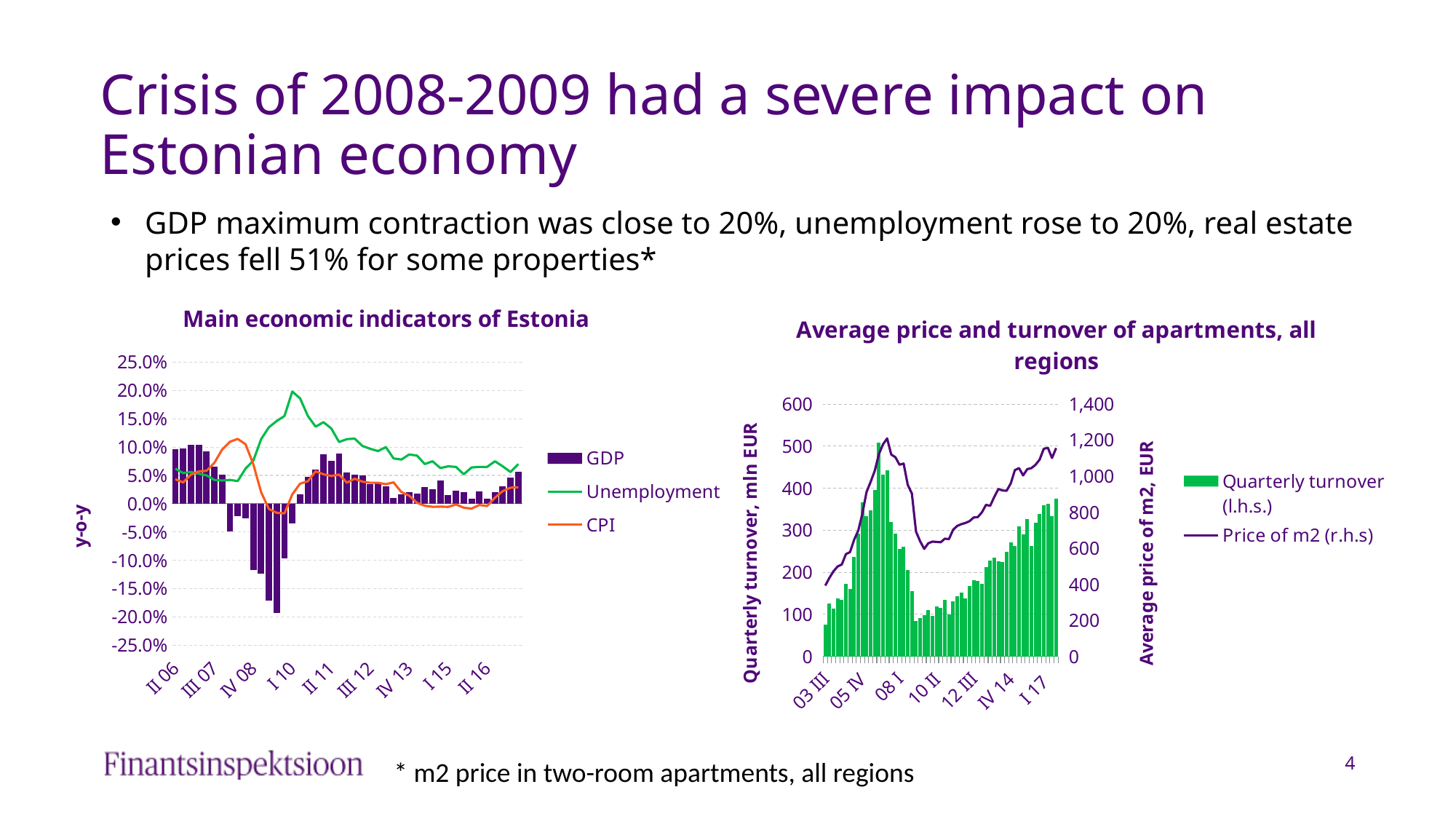
On the 'Main economic indicators of Estonia' chart, which series is drawn as bars? GDP On the 'Average price and turnover of apartments, all regions' chart, is the Quarterly turnover at 03 III greater or less than 100? less On the 'Main economic indicators of Estonia' chart, does Unemployment rise or fall between I 10 and II 16? fall On the 'Main economic indicators of Estonia' chart, how many series does the legend list? 3 On the 'Average price and turnover of apartments, all regions' chart, is the peak Price of m2 greater or less than 1,000? greater On the 'Main economic indicators of Estonia' chart, is the lowest GDP value greater or less than -15.0%? less On the 'Average price and turnover of apartments, all regions' chart, what is the label of the right-hand vertical axis? Average price of m2, EUR On the 'Average price and turnover of apartments, all regions' chart, how many series does the legend list? 2 On the 'Main economic indicators of Estonia' chart, what is the label of the vertical axis? y-o-y On the 'Average price and turnover of apartments, all regions' chart, what kind of chart is used for Quarterly turnover? bar chart On the 'Average price and turnover of apartments, all regions' chart, does the Price of m2 rise or fall between 10 II and I 17? rise